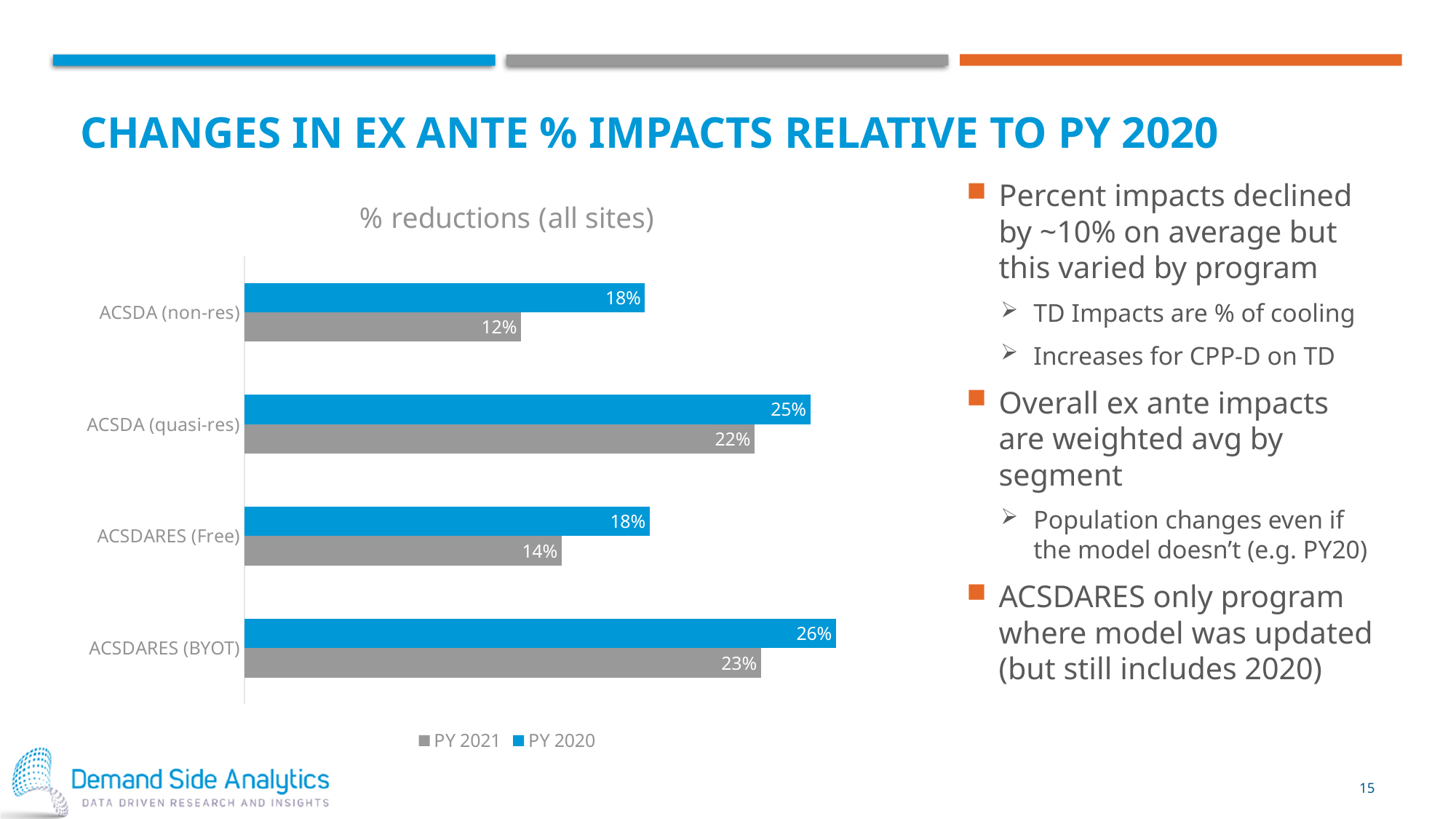
What is the title of the chart? % reductions (all sites) Which category has the highest PY 2020 value? ACSDARES (BYOT) Which category has the lowest PY 2021 value? ACSDA (non-res) What is the PY 2020 value for ACSDA (non-res)? 18% What is the PY 2021 value for ACSDA (quasi-res)? 22% What kind of chart is shown on the slide? Bar chart Which is larger, the PY 2021 value for ACSDA (quasi-res) or the PY 2021 value for ACSDARES (Free)? ACSDA (quasi-res) How many categories are shown on the chart? 4 What is the difference between the PY 2020 and PY 2021 values for ACSDA (non-res)? 6% What is the PY 2021 value for ACSDARES (BYOT)? 23% How many series does the legend list? 2 What is the difference between the PY 2020 and PY 2021 values for ACSDARES (Free)? 4%